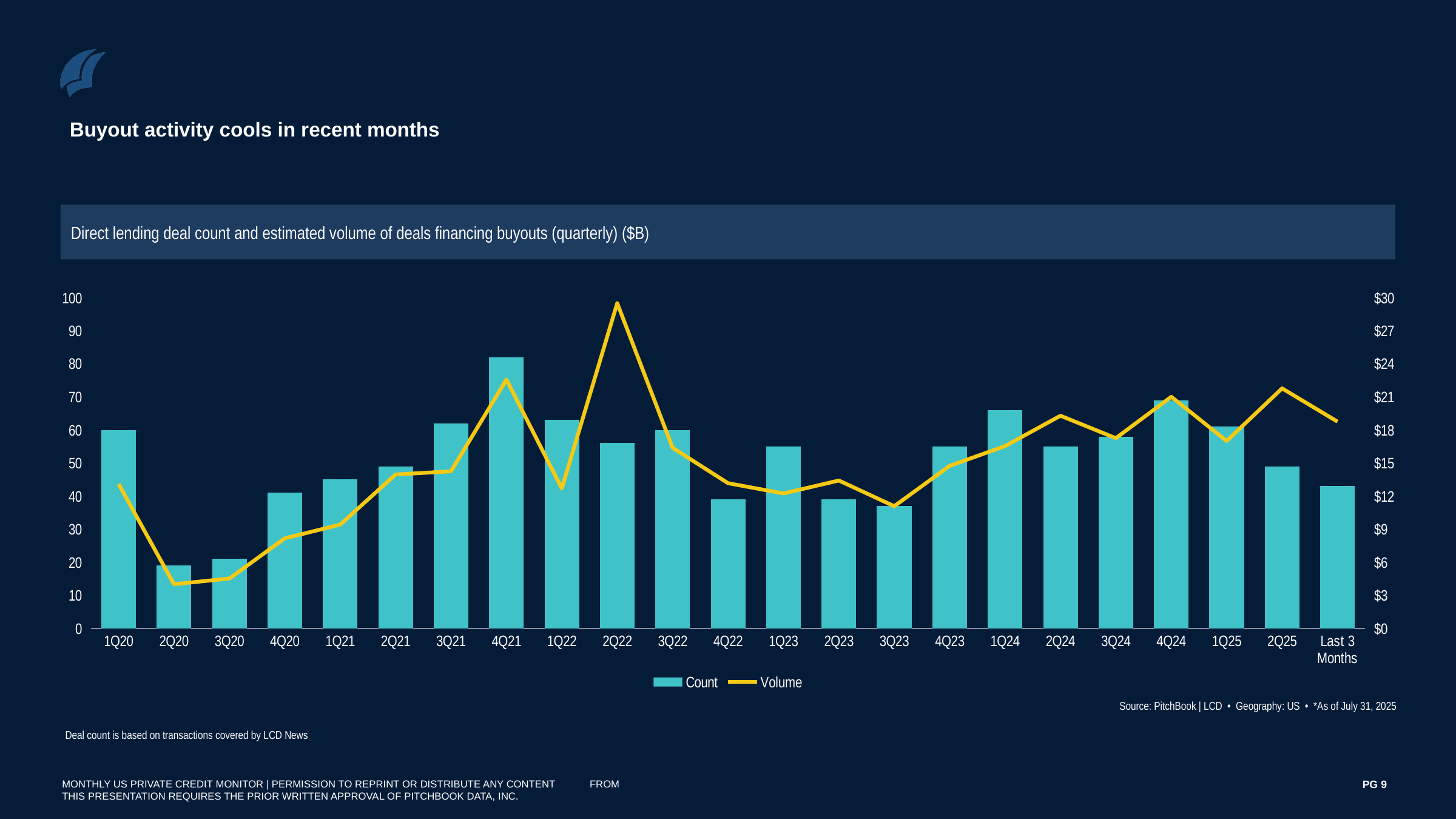
Is the Volume for 2Q22 greater or less than $27? greater Which quarter has the highest deal count bar? 4Q21 How many categories are shown on the x axis? 23 Is the deal count for 4Q21 greater or less than 70? greater Is the deal count for the Last 3 Months greater or less than 50? less Which has the larger deal count, 4Q21 or 1Q22? 4Q21 What colour is the Volume line? Yellow How many series does the legend list? 2 In which quarter does the Volume line reach its peak? 2Q22 What kind of chart is shown on the slide? Combined bar and line chart Which quarter has the lowest deal count bar? 2Q20 Does the deal count rise or fall from 4Q24 to the Last 3 Months? fall